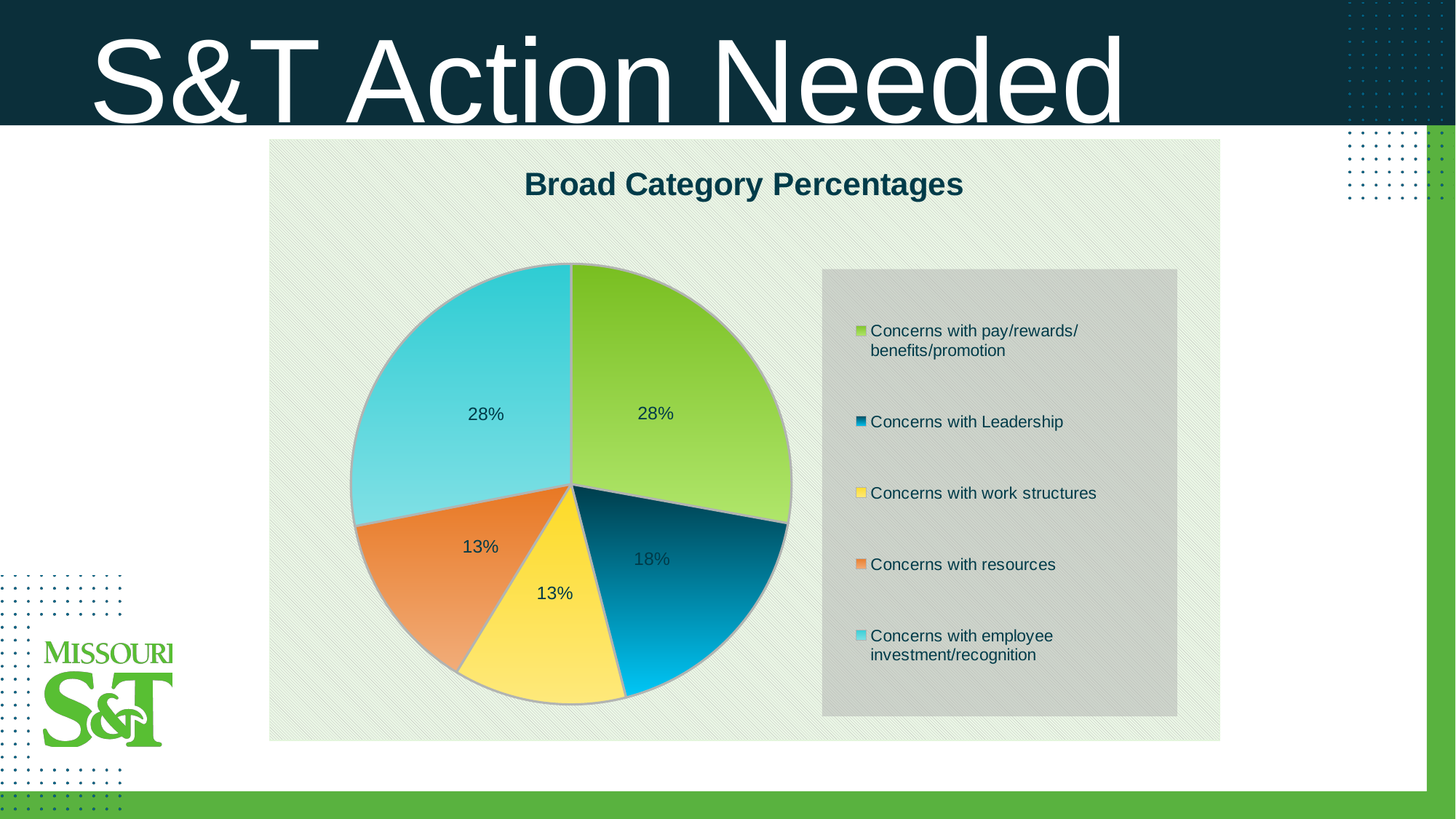
What percentage of the pie is 'Concerns with pay/rewards/benefits/promotion'? 28% What percentage of the pie is 'Concerns with resources'? 13% How many categories does the legend list? 5 What is the difference in percentage points between 'Concerns with pay/rewards/benefits/promotion' and 'Concerns with Leadership'? 10 percentage points What percentage of the pie is 'Concerns with Leadership'? 18% What is the title of the chart? Broad Category Percentages What percentage of the pie is 'Concerns with employee investment/recognition'? 28% What percentage of the pie is 'Concerns with work structures'? 13% Is the share for 'Concerns with Leadership' greater or less than 20%? less What type of chart is shown on the slide? Pie chart Which is larger: the share for 'Concerns with Leadership' or the share for 'Concerns with resources'? Concerns with Leadership Which colour represents 'Concerns with employee investment/recognition' in the chart? Light blue (cyan)